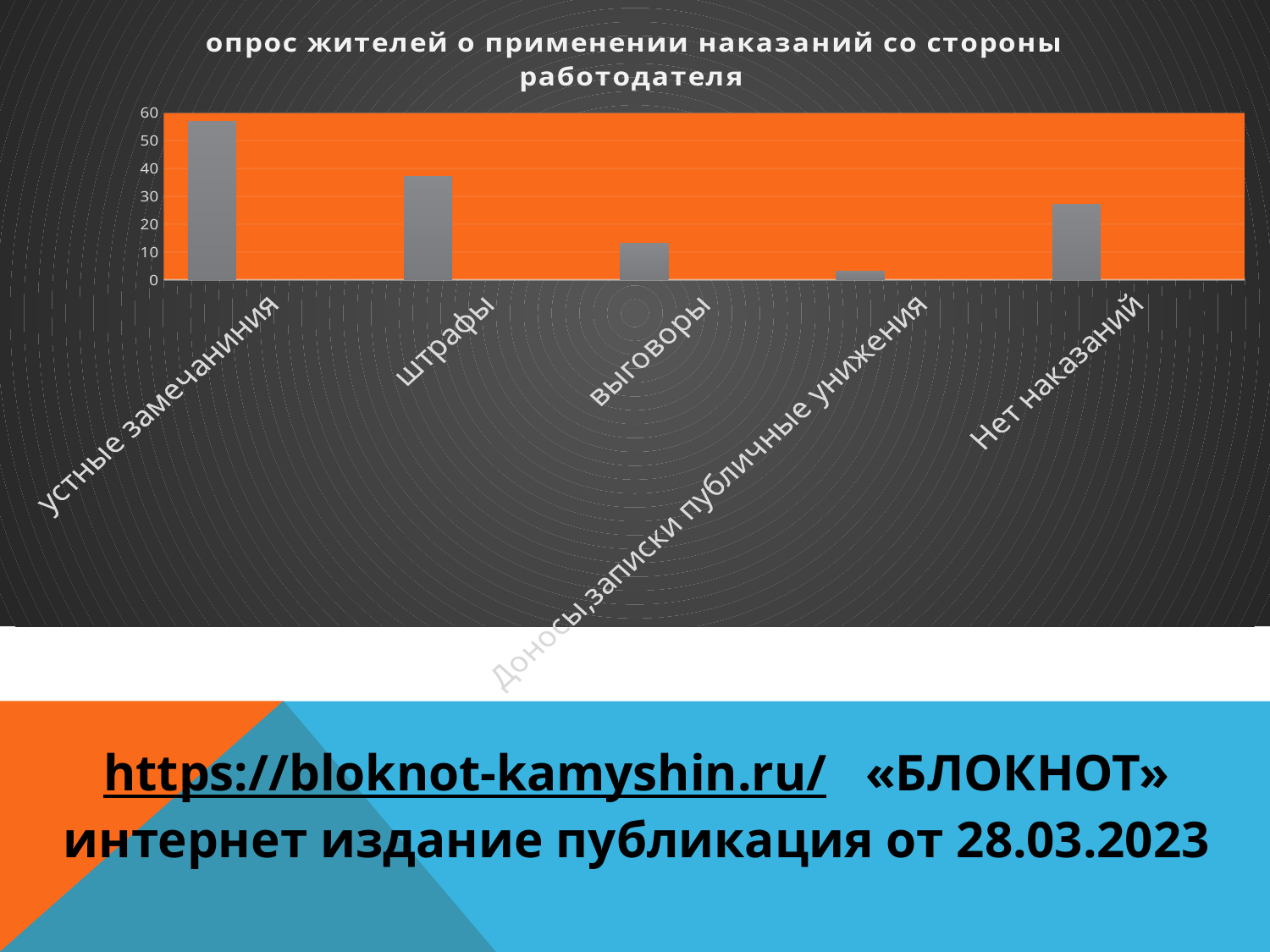
Which category has the lowest value in the chart? Доносы,записки публичные унижения Is the value for штрафы greater or less than 30? greater Is the value for Нет наказаний greater or less than 20? greater How many categories are shown on the x axis of the chart? 5 Is the value for устные замечаниния greater or less than 50? greater What is the title of the chart? опрос жителей о применении наказаний со стороны работодателя What kind of chart is shown on the slide? bar chart Which is larger, the value for выговоры or the value for Нет наказаний? Нет наказаний Which category has the highest value in the chart? устные замечаниния Which is larger, the value for штрафы or the value for Нет наказаний? штрафы